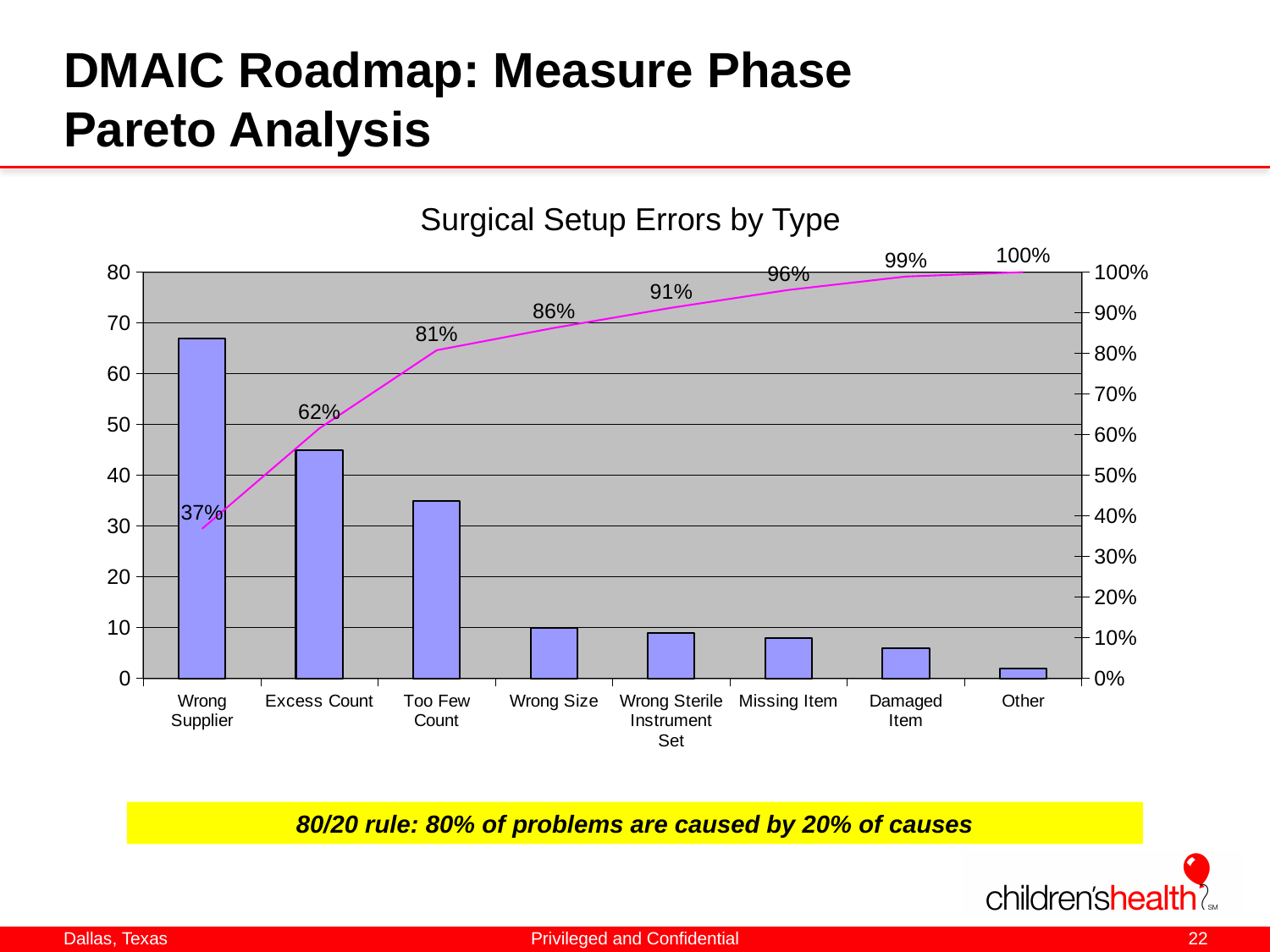
Is the bar value for Wrong Supplier greater or less than 60? greater How many error type categories are shown on the x axis? 8 Which category has the tallest bar? Wrong Supplier What is the title of the chart? Surgical Setup Errors by Type Is the bar value for Damaged Item greater or less than 10? less What cumulative percentage is labelled at Too Few Count? 81% What cumulative percentage is labelled at Other? 100% What cumulative percentage is labelled at Missing Item? 96% What kind of chart is shown on the slide? A combined bar and line chart (Pareto chart) What cumulative percentage is labelled at Wrong Supplier? 37% Which category has the shortest bar? Other By how many percentage points does the cumulative percentage rise from Wrong Supplier (37%) to Excess Count (62%)? 25 percentage points